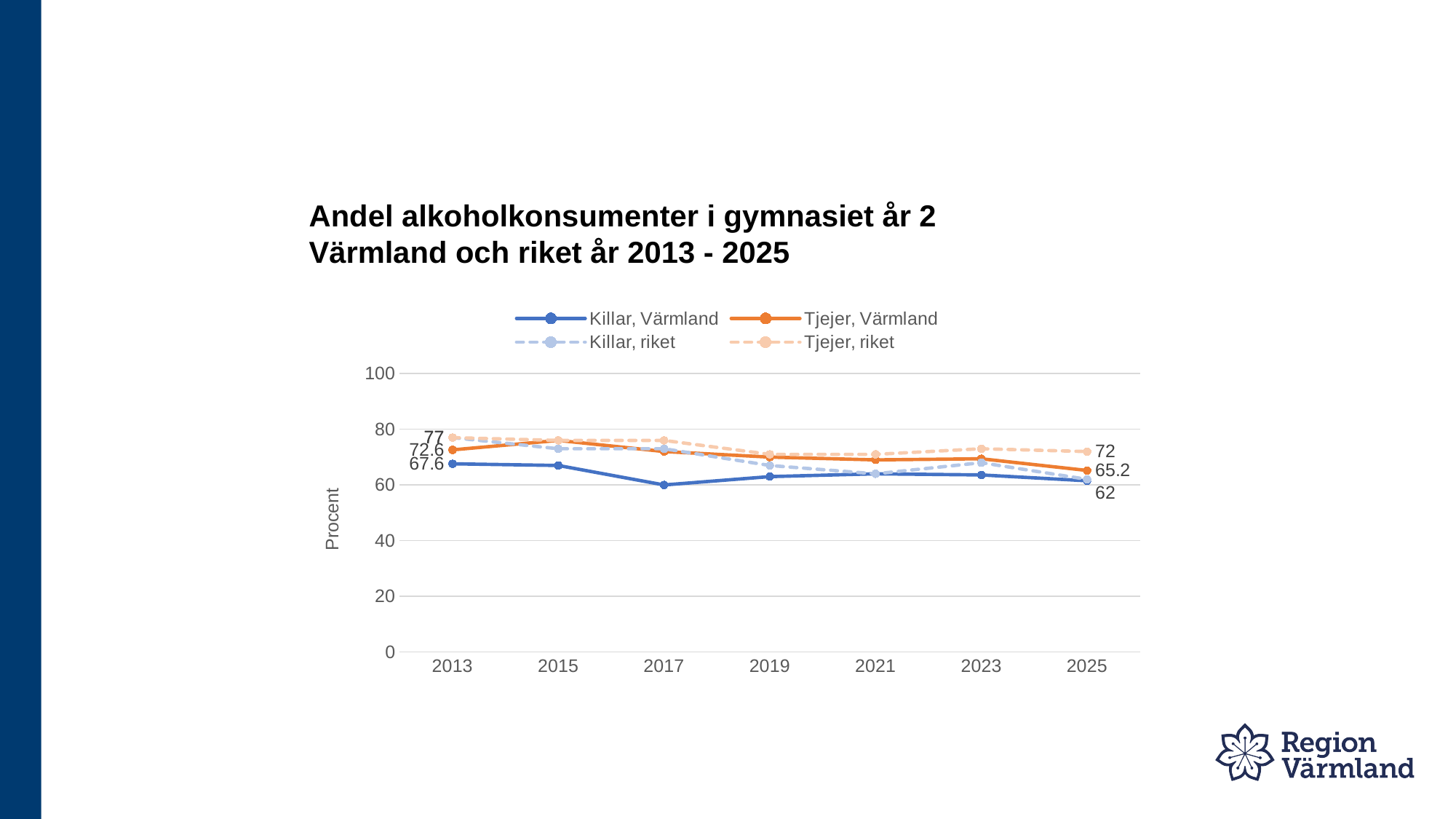
What is the value for Tjejer, Värmland in 2013? 72.6 What is the value for Tjejer, riket in 2025? 72 What is the value for Tjejer, Värmland in 2025? 65.2 What kind of chart is shown on the slide? line chart What is the value for Killar, Värmland in 2013? 67.6 How many series does the legend list? 4 What is the value for Killar, Värmland in 2025? 62 In 2025, which is higher: Tjejer, Värmland or Killar, Värmland? Tjejer, Värmland Is the value for Killar, Värmland in 2017 greater or less than 80? less How many years are shown on the x axis? 7 By how much did the value for Killar, Värmland fall from 2013 to 2025? 5.6 By how much did the value for Tjejer, Värmland fall from 2013 to 2025? 7.4